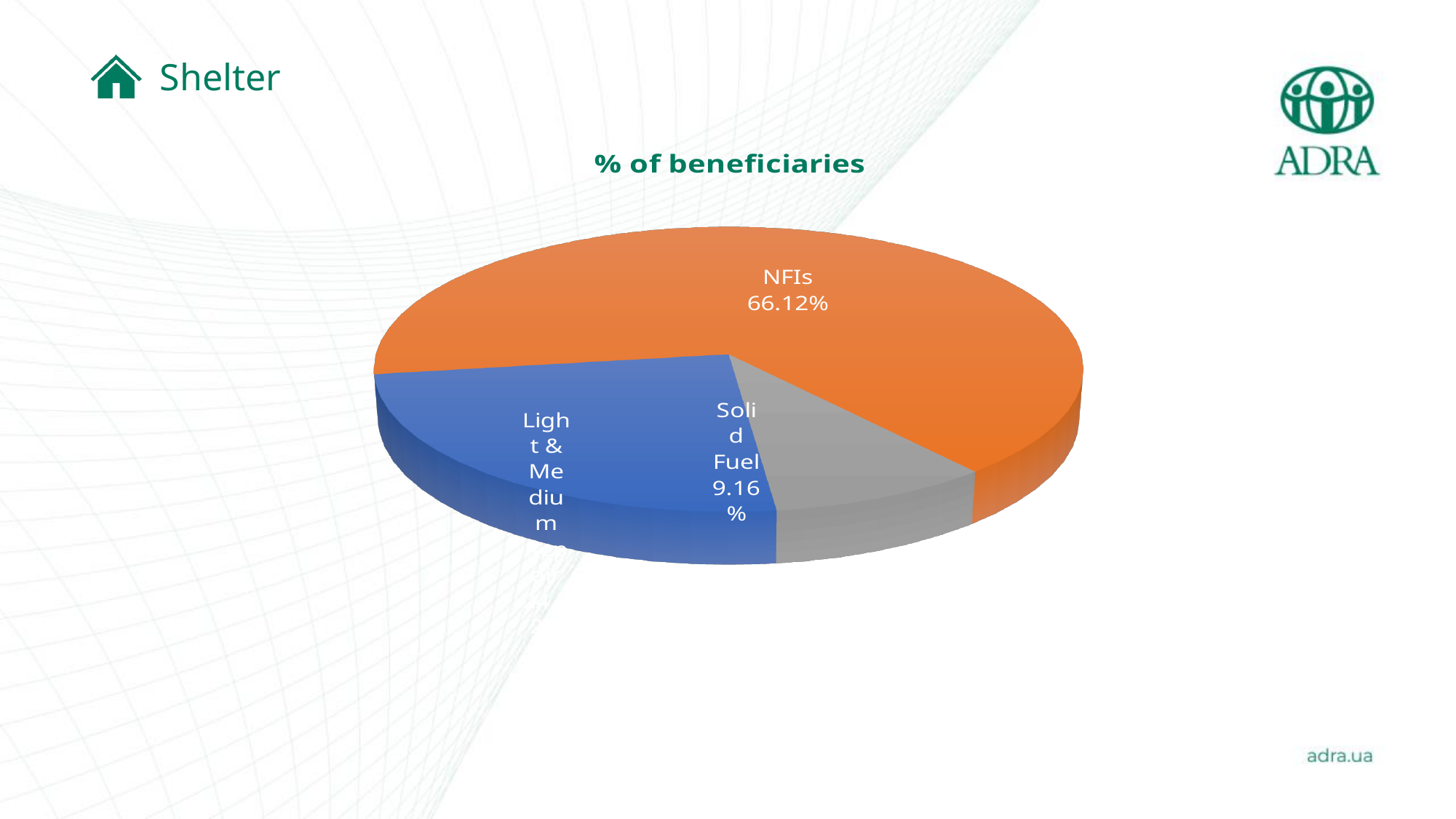
What percentage of beneficiaries does the NFIs slice represent? 66.12% What is the difference in percentage points between the NFIs share and the Solid Fuel share? 56.96 How many slices does the pie chart have? 3 Which is larger, the NFIs slice or the Solid Fuel slice? NFIs Which category has the largest share of beneficiaries? NFIs What colour is the NFIs slice? Orange Which is larger, the Light & Medium slice or the Solid Fuel slice? Light & Medium What kind of chart is shown on the slide? Pie chart Which category has the smallest share of beneficiaries? Solid Fuel What is the title of the chart? % of beneficiaries What percentage of beneficiaries does the Solid Fuel slice represent? 9.16%